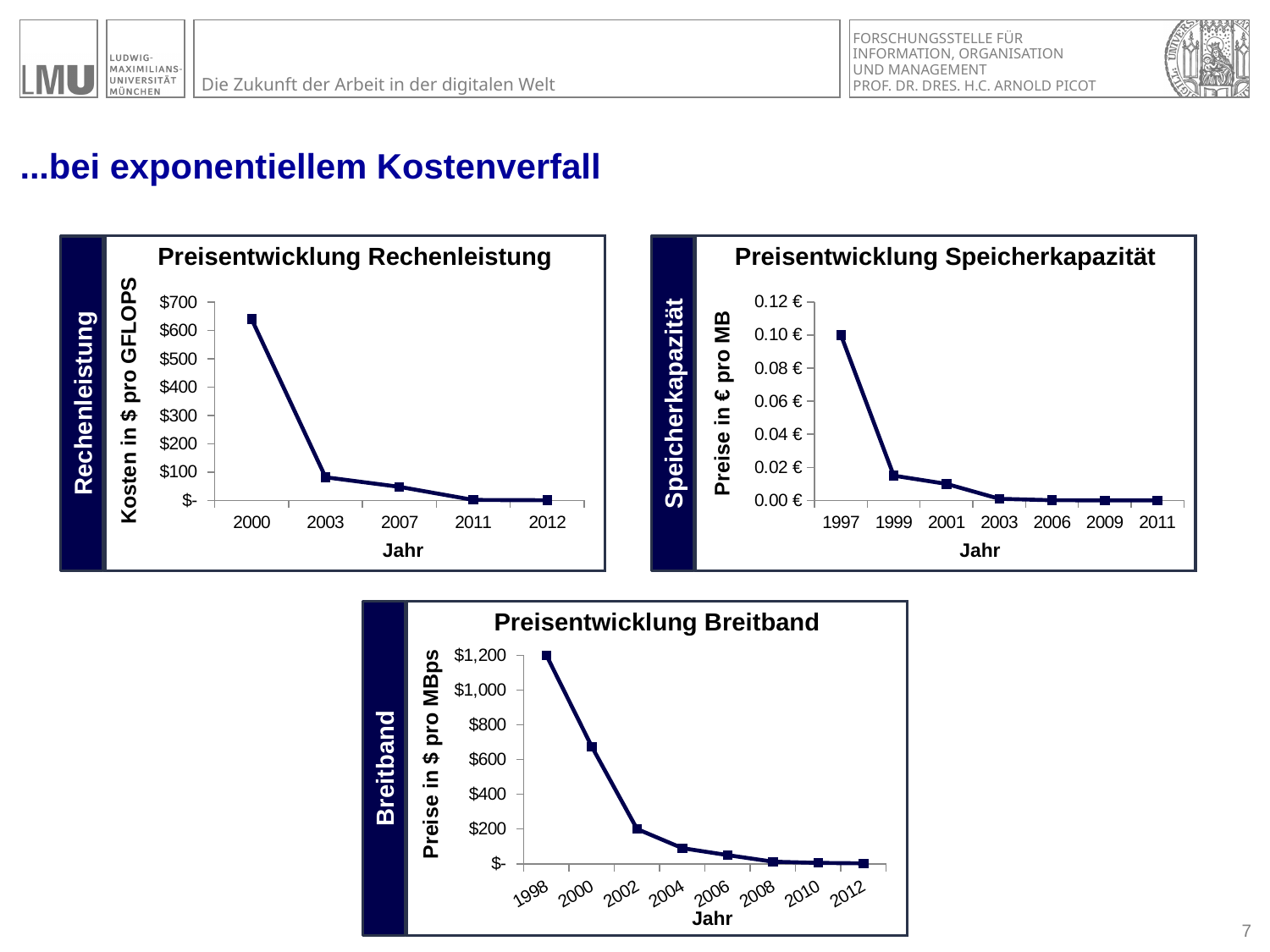
In the 'Preisentwicklung Speicherkapazität' chart, what is the price per MB in 1997? 0.10 € In the 'Preisentwicklung Breitband' chart, which is larger, the value for 2002 or the value for 2004? 2002 In the 'Preisentwicklung Rechenleistung' chart, is the value for 2000 greater or less than $600? greater What kind of chart is the 'Preisentwicklung Rechenleistung' chart? line chart How many years are plotted on the x axis of the 'Preisentwicklung Rechenleistung' chart? 5 In the 'Preisentwicklung Breitband' chart, is the value for 2000 greater or less than $600? greater How many years are plotted on the x axis of the 'Preisentwicklung Speicherkapazität' chart? 7 In the 'Preisentwicklung Speicherkapazität' chart, is the value for 1999 greater or less than 0.02 €? less In the 'Preisentwicklung Rechenleistung' chart, which year has the highest cost per GFLOPS? 2000 Do the values in the 'Preisentwicklung Breitband' chart rise or fall from 1998 to 2012? fall In the 'Preisentwicklung Breitband' chart, what is the price per MBps in 1998? $1,200